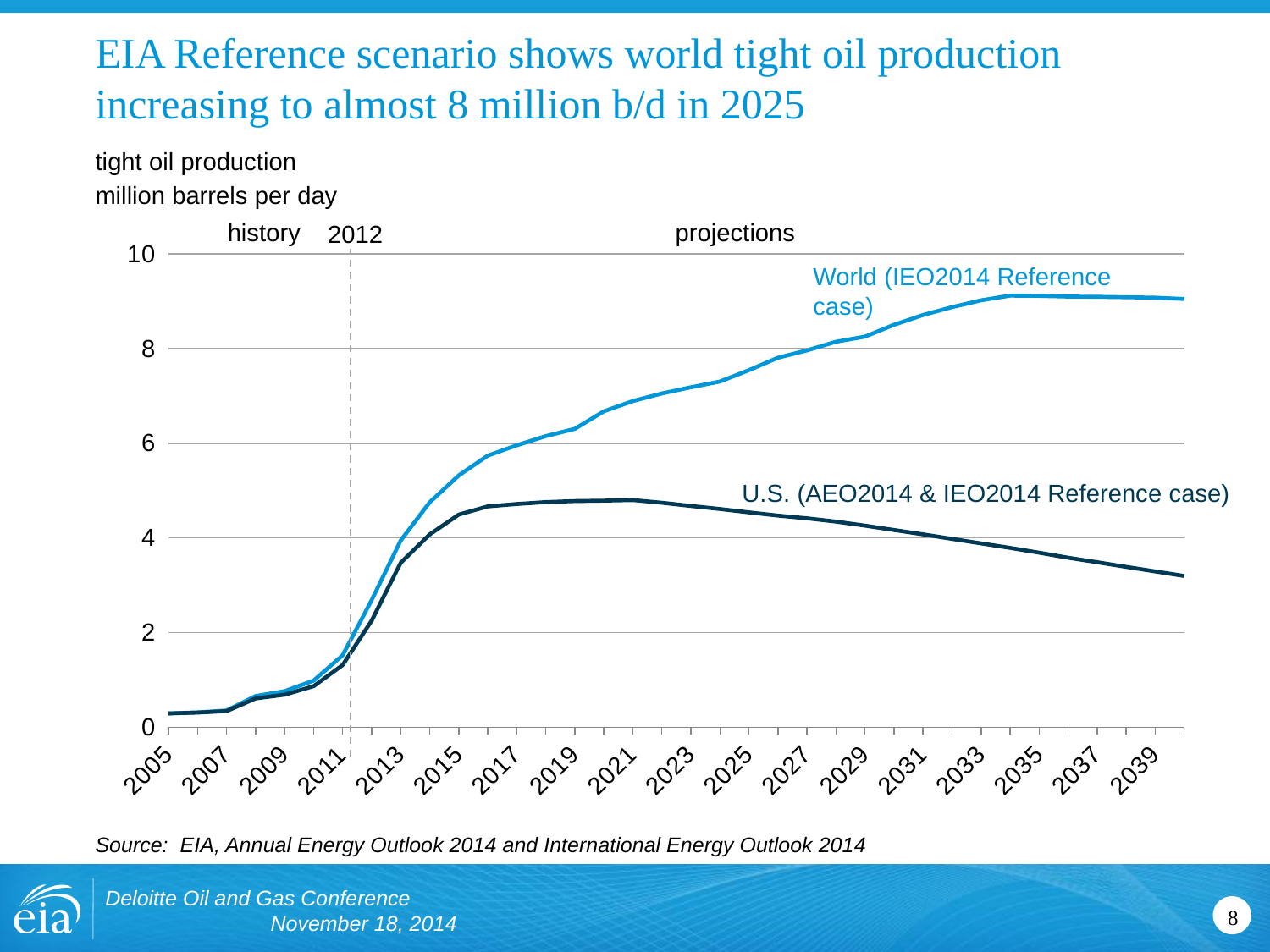
Is the World (IEO2014 Reference case) value in 2015 greater or less than 6? less In 2039, which series has the higher value: World (IEO2014 Reference case) or U.S. (AEO2014 & IEO2014 Reference case)? World (IEO2014 Reference case) How many series are plotted on the chart? 2 Is the World (IEO2014 Reference case) value in 2025 greater or less than 6? greater What are the two series plotted on the chart? World (IEO2014 Reference case) and U.S. (AEO2014 & IEO2014 Reference case) What kind of chart is shown on the slide? line chart What unit is the y axis measured in? million barrels per day Is the World (IEO2014 Reference case) value in 2039 greater or less than 8? greater Does the World (IEO2014 Reference case) series rise or fall between 2012 and 2035? rise Does the U.S. (AEO2014 & IEO2014 Reference case) series rise or fall between 2021 and 2039? fall